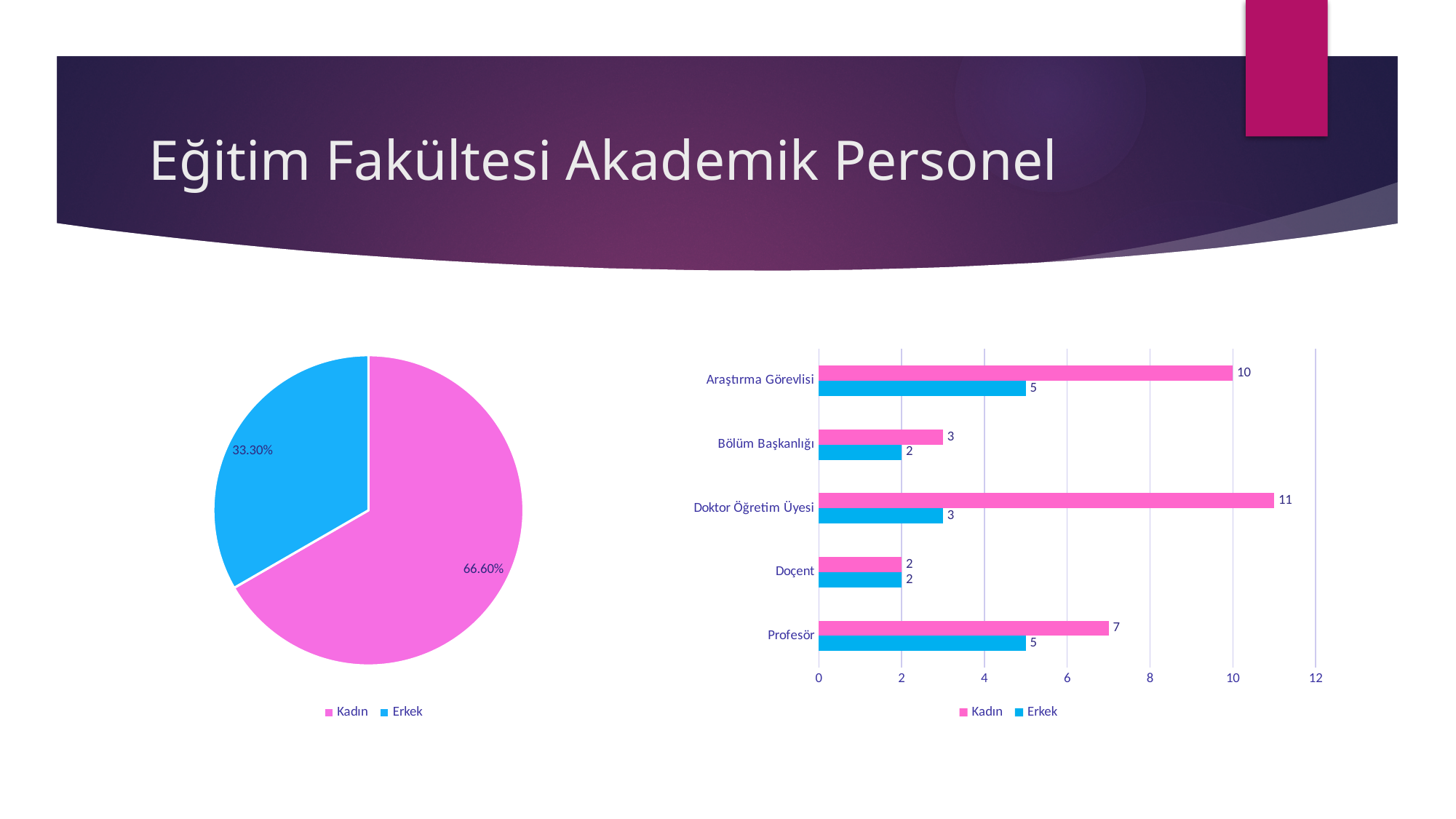
In the bar chart on the right, what is the Erkek value for Araştırma Görevlisi? 5 How many categories are shown in the bar chart on the right? 5 In the bar chart on the right, what is the difference between the Kadın and Erkek values for Doktor Öğretim Üyesi? 8 How many series does the legend of the bar chart on the right list? 2 In the bar chart on the right, which category has the highest Kadın value? Doktor Öğretim Üyesi In the bar chart on the right, which category has the lowest Kadın value? Doçent What kind of chart is the chart on the right? bar chart In the pie chart on the left, what share does Erkek have? 33.30% In the pie chart on the left, what share does Kadın have? 66.60% What kind of chart is the chart on the left? pie chart In the bar chart on the right, which is larger for Profesör: Kadın or Erkek? Kadın In the bar chart on the right, what is the Kadın value for Doktor Öğretim Üyesi? 11